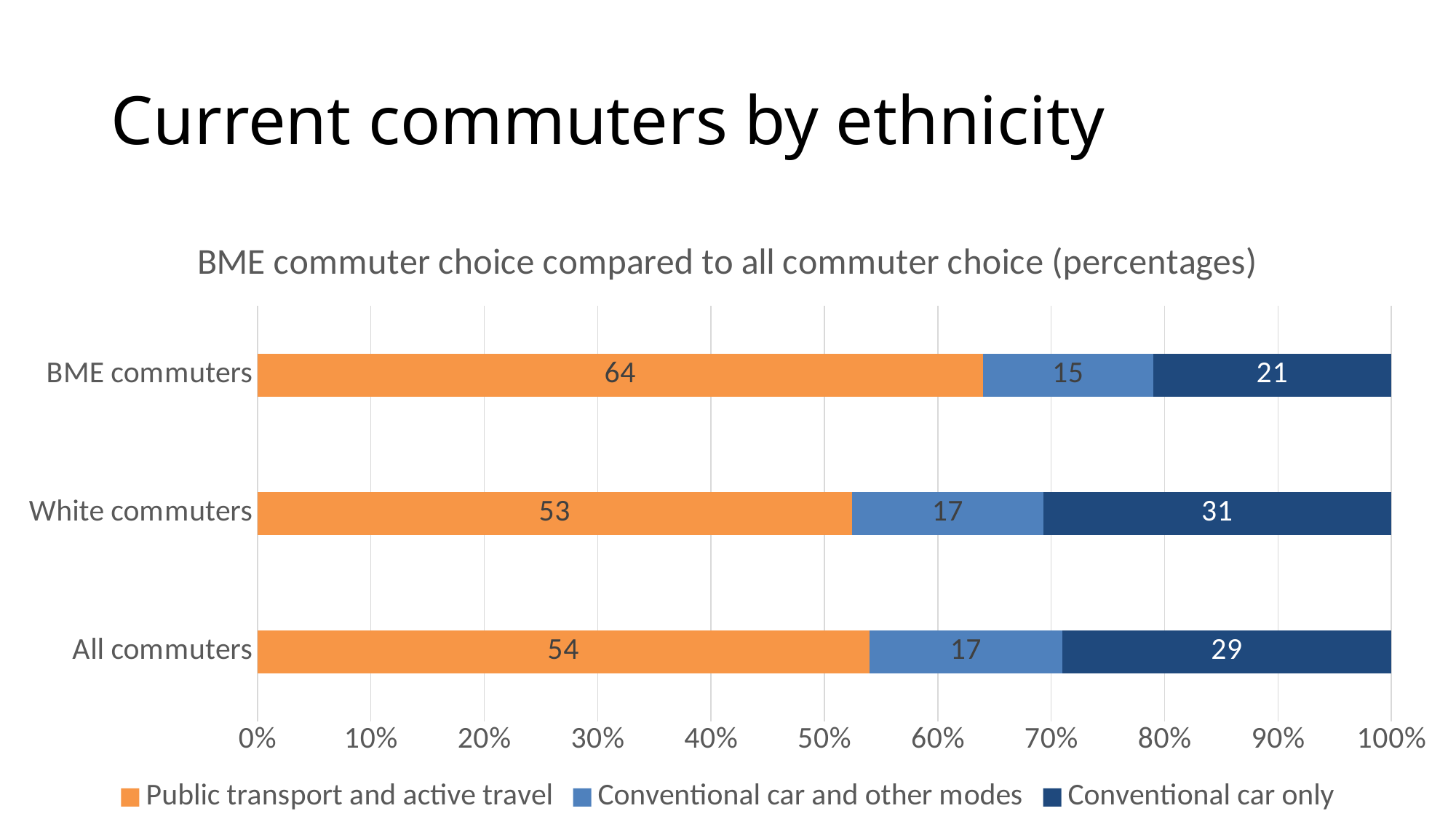
What kind of chart is shown on the slide? Stacked bar chart What is the difference between the Conventional car only values for White commuters and BME commuters? 10 What is the value for Conventional car and other modes for All commuters? 17 Which category has the lowest value for Conventional car only? BME commuters How many categories are shown on the chart? 3 What is the title of the chart? BME commuter choice compared to all commuter choice (percentages) What is the value for Public transport and active travel for BME commuters? 64 How many series does the legend list? 3 What is the total of the stacked bar for BME commuters? 100 Which category has the highest value for Public transport and active travel? BME commuters What is the value for Conventional car only for White commuters? 31 Which is larger: the Public transport and active travel value for White commuters or for All commuters? All commuters